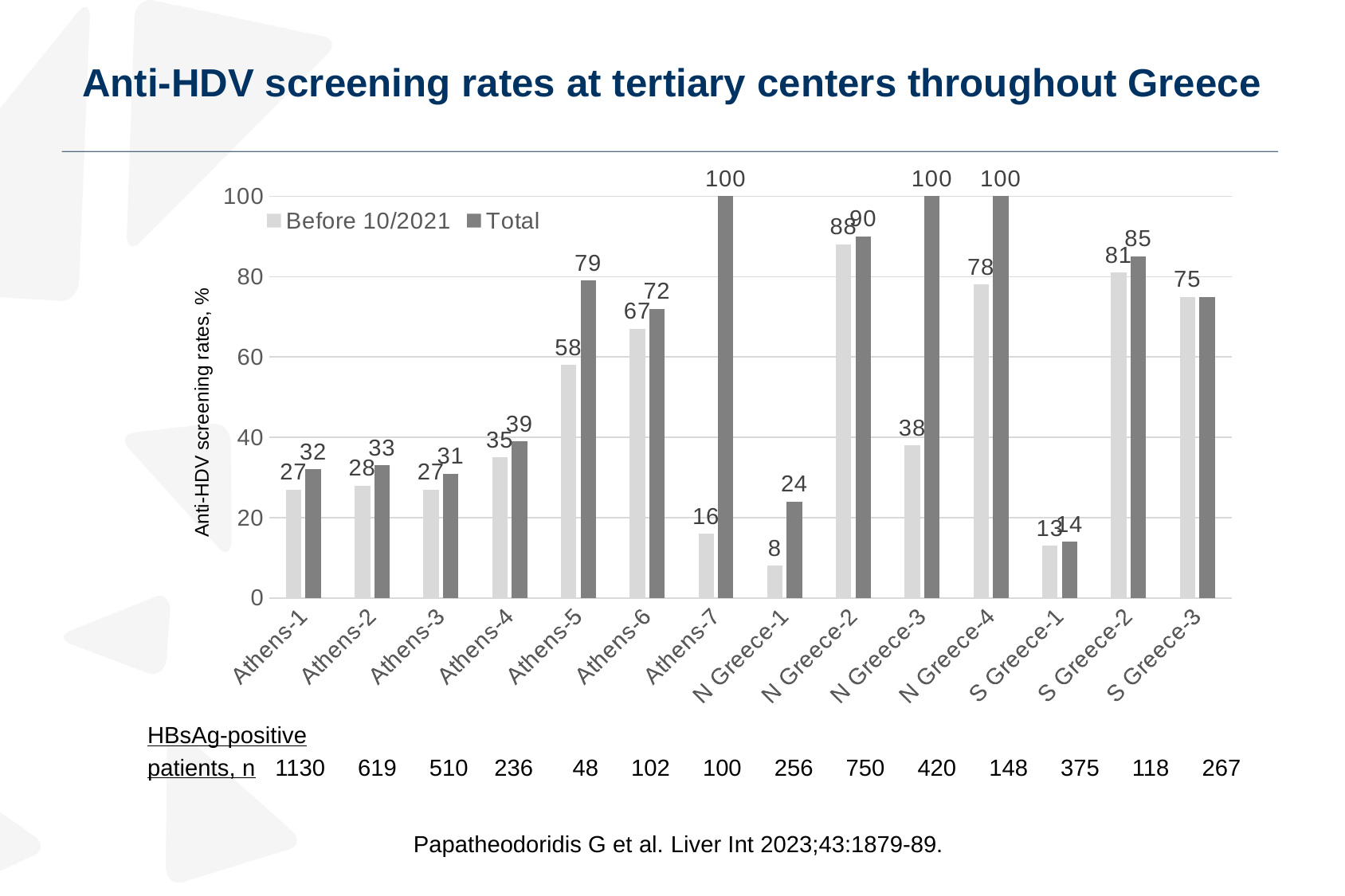
What is the Total screening rate for N Greece-1? 24 For Athens-7, how much higher is the Total rate than the Before 10/2021 rate? 84 How many centers are shown on the x axis of the chart? 14 How many series does the legend list? 2 What kind of chart is shown on the slide? Bar chart Which center has the highest Before 10/2021 screening rate? N Greece-2 What is the Total anti-HDV screening rate for Athens-5? 79 Which center has the lowest Before 10/2021 screening rate? N Greece-1 What is the Before 10/2021 screening rate for Athens-7? 16 Which center has the lowest Total screening rate? S Greece-1 Which has a higher Total screening rate, Athens-5 or Athens-6? Athens-5 What is the label of the y axis? Anti-HDV screening rates, %